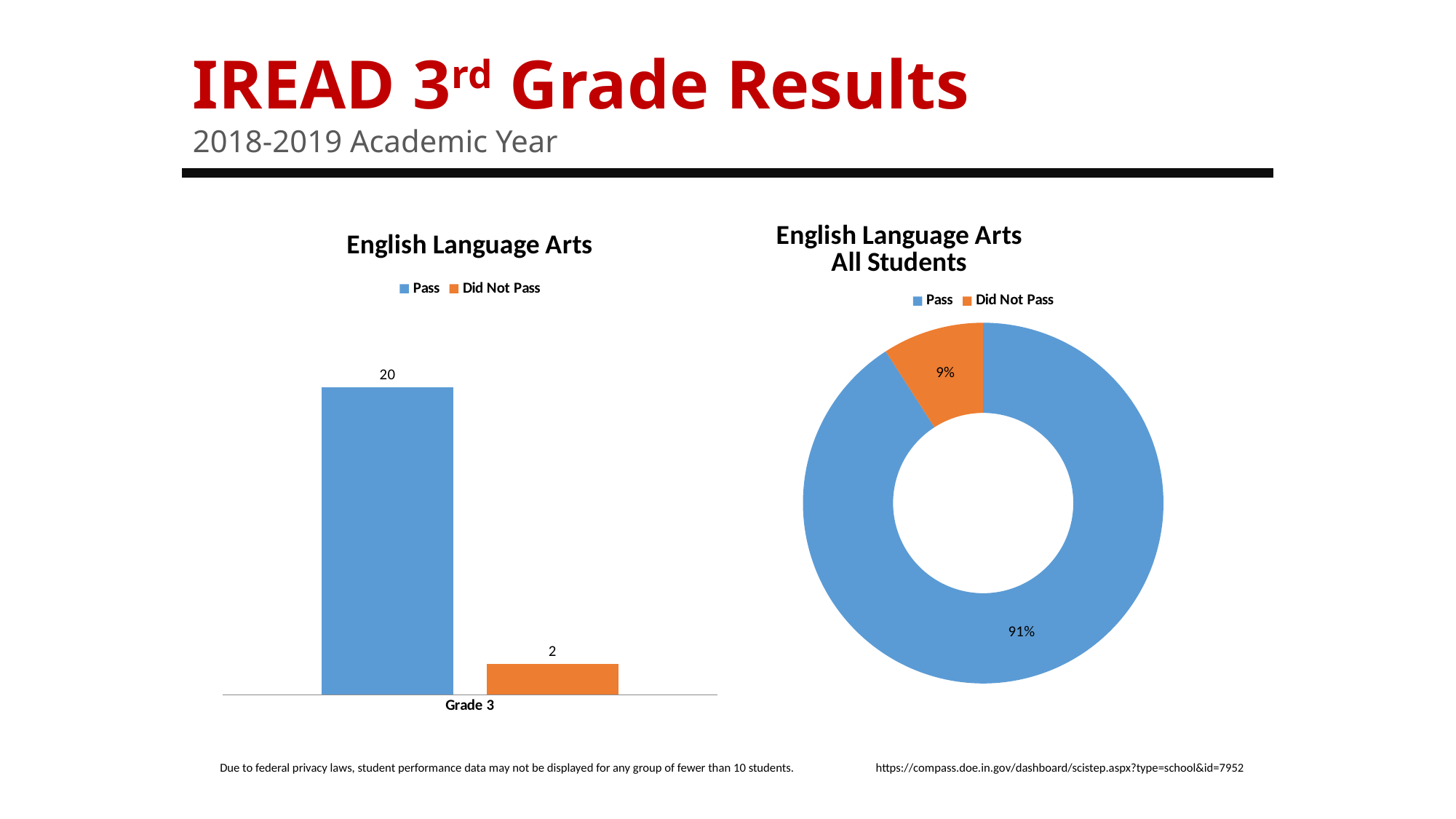
In the 'English Language Arts All Students' chart, what colour represents Pass? Blue What kind of chart is the 'English Language Arts All Students' chart on the right? Doughnut chart In the 'English Language Arts' bar chart, which series has the higher value for Grade 3? Pass In the 'English Language Arts' bar chart, how many series does the legend list? 2 In the 'English Language Arts All Students' chart, which slice is the smallest? Did Not Pass What kind of chart is the 'English Language Arts' chart on the left? Bar chart In the 'English Language Arts All Students' chart, what share of students passed? 91% In the 'English Language Arts' bar chart, what is the value for Did Not Pass in Grade 3? 2 In the 'English Language Arts All Students' chart, what share of students did not pass? 9% In the 'English Language Arts' bar chart, what is the difference between the Pass and Did Not Pass values for Grade 3? 18 In the 'English Language Arts' bar chart, how many categories are shown on the x axis? 1 In the 'English Language Arts' bar chart, what is the value for Pass in Grade 3? 20